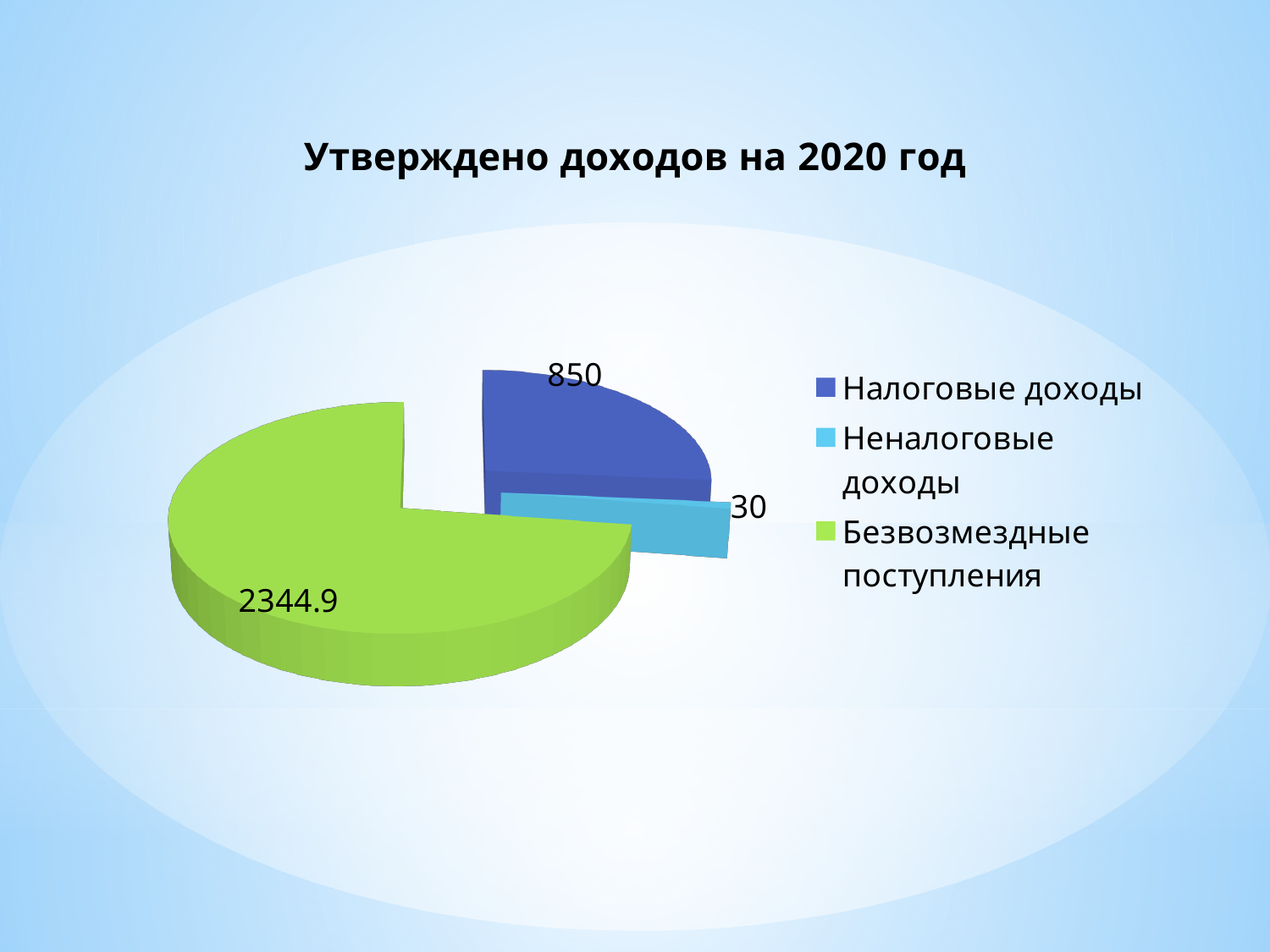
What is the title of the chart? Утверждено доходов на 2020 год Which category has the largest slice of the pie? Безвозмездные поступления What is the value for Безвозмездные поступления? 2344.9 Which category has the smallest slice of the pie? Неналоговые доходы What is the value for Налоговые доходы? 850 How many categories does the legend list? 3 What is the value for Неналоговые доходы? 30 What is the difference between the values for Налоговые доходы and Неналоговые доходы? 820 What colour is the slice for Безвозмездные поступления? Green Which is larger, the value for Налоговые доходы or the value for Неналоговые доходы? Налоговые доходы What is the difference between the values for Безвозмездные поступления and Налоговые доходы? 1494.9 What type of chart is shown on the slide? Pie chart